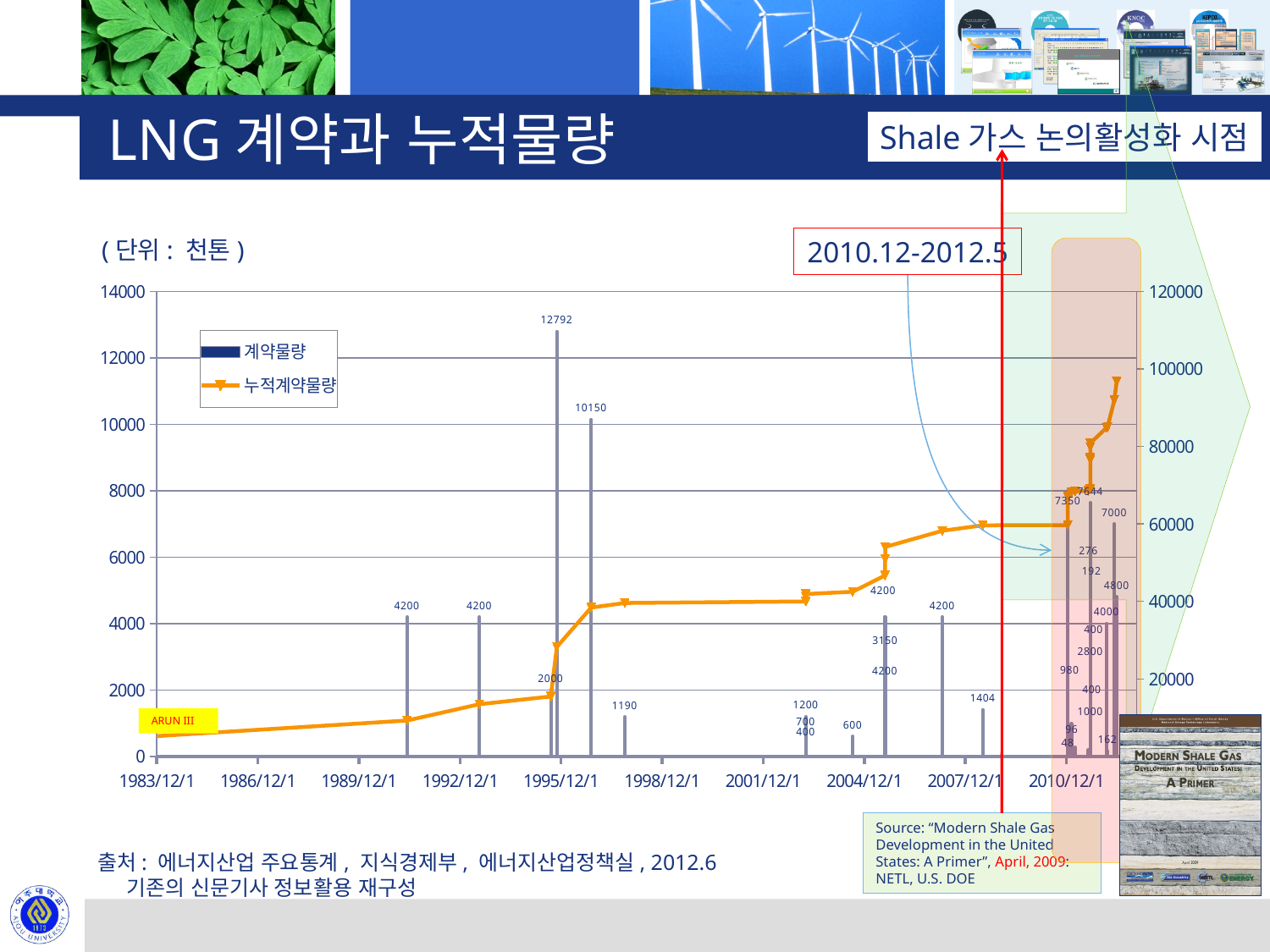
What are the two series named in the legend? 계약물량 and 누적계약물량 What is the value of the bar labelled just before the 12792 bar, around 1995? 2000 What is the second-highest labelled 계약물량 bar value, shown just after the 12792 bar? 10150 Does the 누적계약물량 line rise or fall from 1983/12/1 to 2010/12/1? rise What kind of chart is shown on the slide? Combined bar and line chart What is the difference between the two tallest labelled bars, 12792 and 10150? 2642 What is the highest labelled value among the 계약물량 bars? 12792 What is the maximum value shown on the left vertical axis? 14000 Is the 누적계약물량 line value at 2007/12/1 greater or less than 6000 on the left axis? greater Which is larger, the bar labelled 12792 or the bar labelled 10150? 12792 How many series does the chart legend list? 2 What is the title of the chart on the slide? LNG 계약과 누적물량